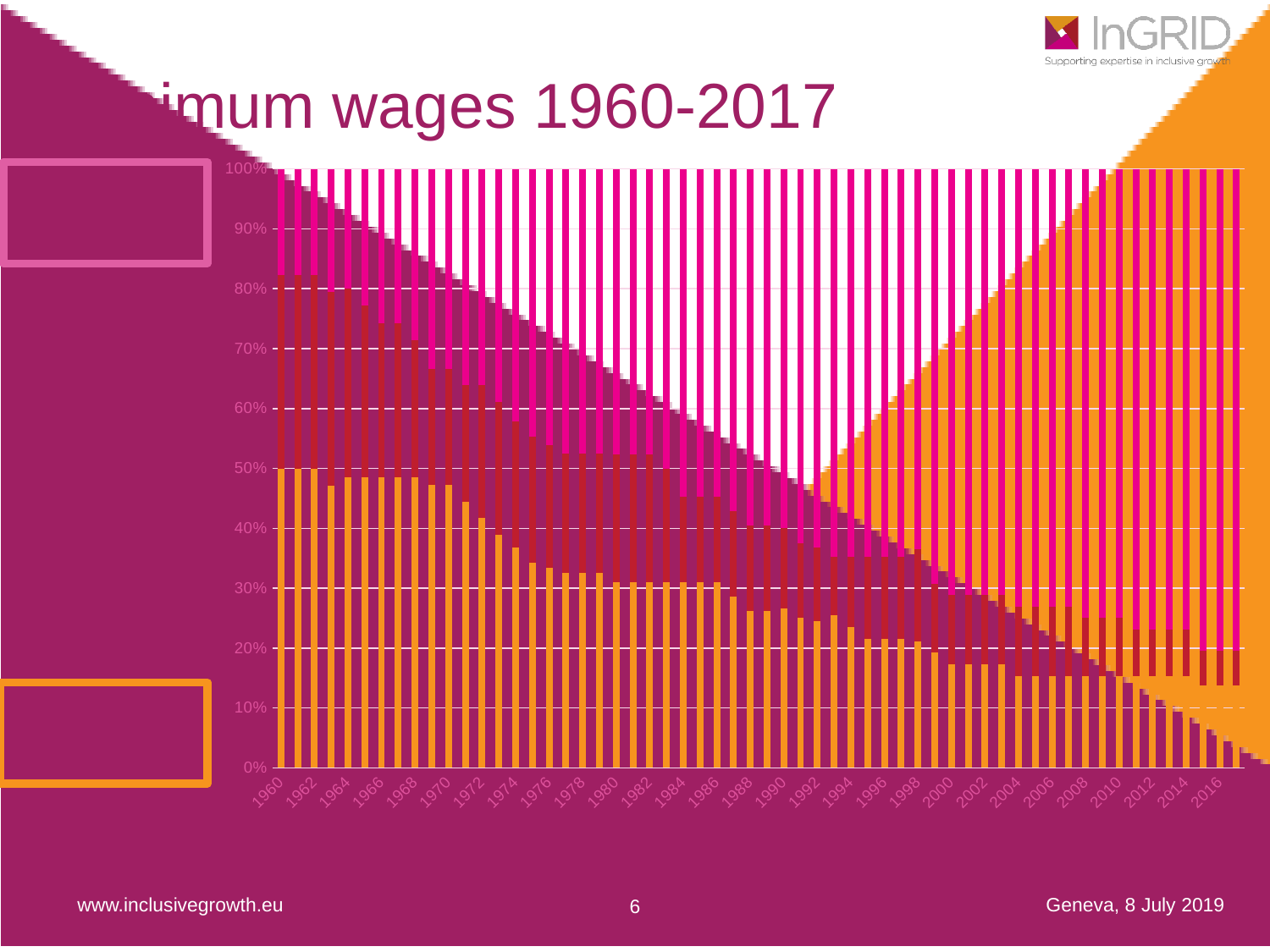
Is the orange bar for 1960 greater or less than 40%? greater Is the orange bar for 2000 greater or less than 30%? less Which is larger, the orange bar for 1960 or the orange bar for 2016? 1960 Do the orange bars rise or fall from 1960 to 2017? fall Is the orange bar for 1980 greater or less than 40%? less What is the first year labelled on the horizontal axis? 1960 Which is larger, the orange bar for 1970 or the orange bar for 1990? 1970 What kind of chart is shown on the slide? bar chart What is the highest value shown on the vertical axis? 100%